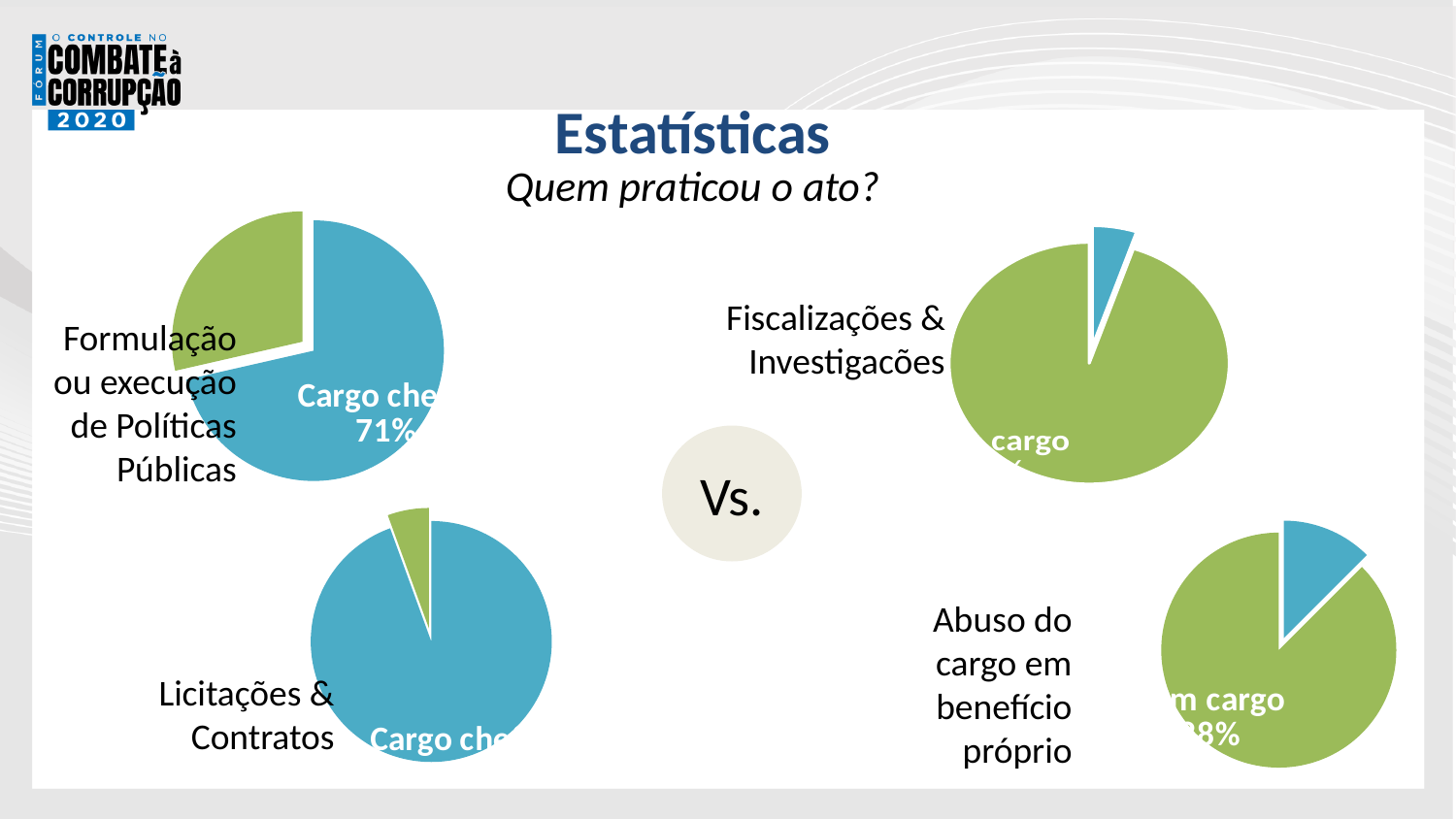
In the 'Fiscalizações & Investigações' pie chart, is the share of the blue slice greater or less than 25%? less In the 'Formulação ou execução de Políticas Públicas' pie chart, what percentage is printed on the larger (blue) slice? 71% How many slices does each pie chart on the slide have? 2 In the 'Licitações & Contratos' pie chart, which slice is larger, the blue one or the green one? Blue How many pie charts are on the slide? 4 In the 'Abuso do cargo em benefício próprio' pie chart, which slice is larger, the blue one or the green one? Green What kind of charts are shown on the slide? Pie charts In the 'Formulação ou execução de Políticas Públicas' pie chart, which slice is larger, the blue one or the green one? Blue What is the main title of the slide containing the pie charts? Estatísticas In the 'Licitações & Contratos' pie chart, is the share of the blue slice greater or less than 50%? greater What question is written as the subtitle above the pie charts? Quem praticou o ato?